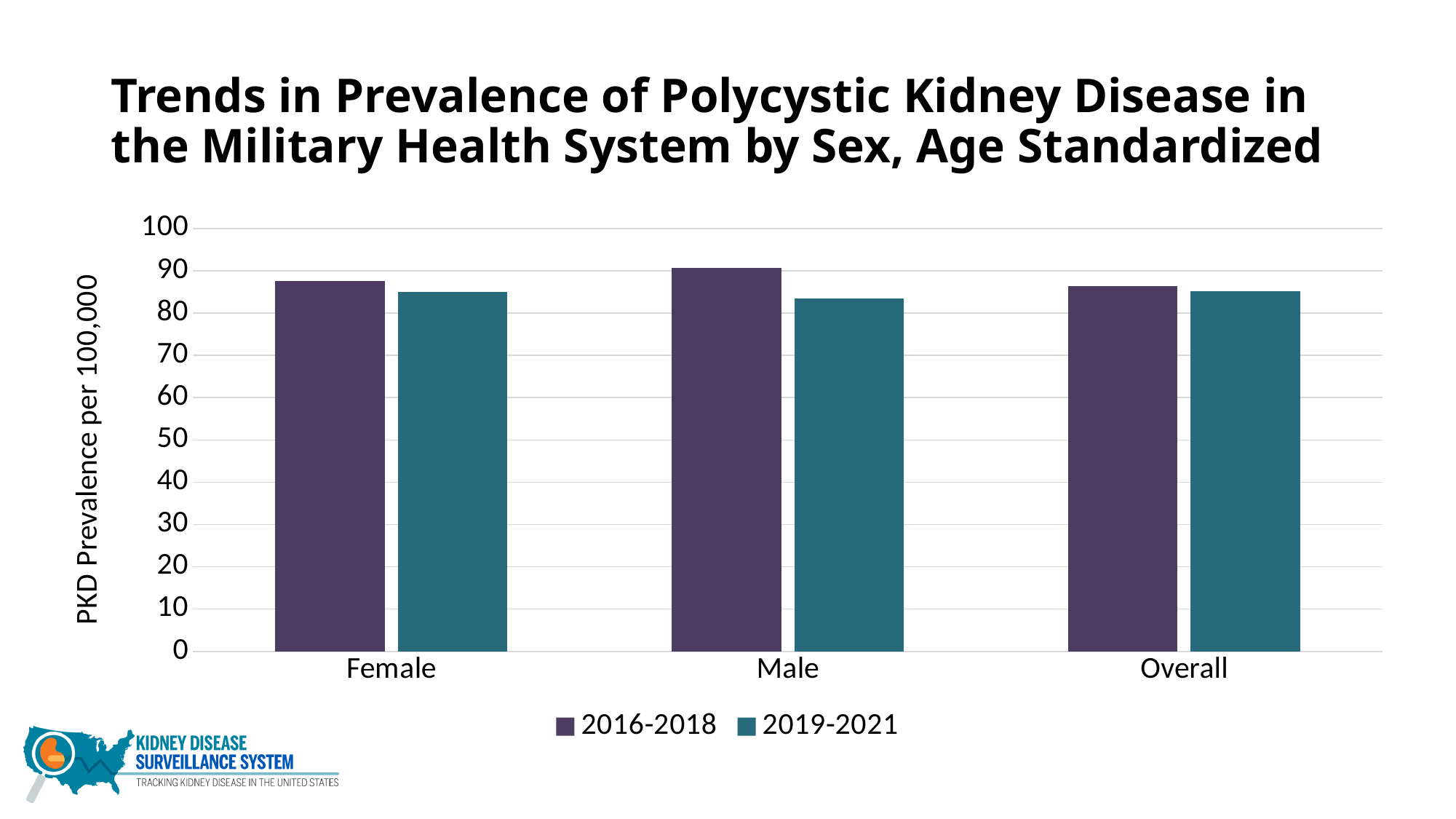
From 2016-2018 to 2019-2021, did the Male prevalence rise or fall? Fall How many series does the legend list? 2 How many categories are shown on the x axis? 3 What is the label on the y axis? PKD Prevalence per 100,000 For Male, which series has the larger value, 2016-2018 or 2019-2021? 2016-2018 Which category has the highest value for the 2016-2018 series? Male Which category has the lowest value for the 2019-2021 series? Male Is the value for Overall in 2019-2021 greater or less than 70? greater Is the value for Male in 2019-2021 greater or less than 90? less What kind of chart is shown on the slide? Bar chart Which series is shown in the purple bars? 2016-2018 Is the value for Female in 2016-2018 greater or less than 80? greater